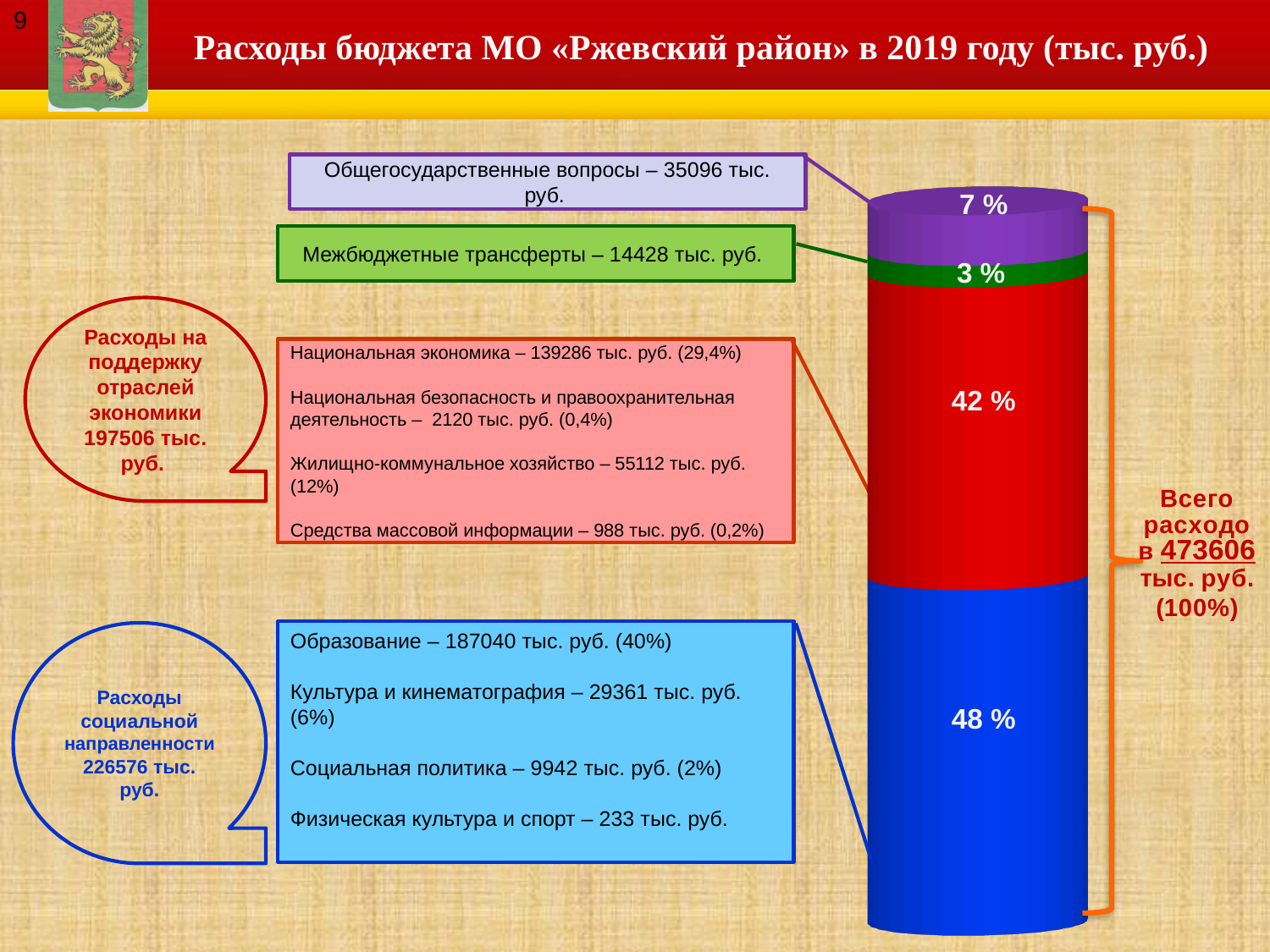
What percentage is shown on the purple (top) segment of the bar? 7 % Which segment of the bar has the largest share? 48 % (blue, social expenditures) What percentage is shown on the green segment of the bar? 3 % How many segments does the stacked bar on the slide have? 4 What percentage is shown on the red segment of the bar? 42 % What is the difference in percentage points between the blue segment (48 %) and the red segment (42 %)? 6 What total expenditure amount does the bracket next to the bar indicate? 473606 тыс. руб. (100%) What kind of chart is shown on the slide? stacked bar chart What percentage is shown on the blue (bottom) segment of the bar? 48 % What amount is given for Межбюджетные трансферты, linked to the green segment? 14428 тыс. руб. Which segment of the bar has the smallest share? 3 % (green, Межбюджетные трансферты) Which is larger: the purple segment or the green segment? the purple segment (7 %)